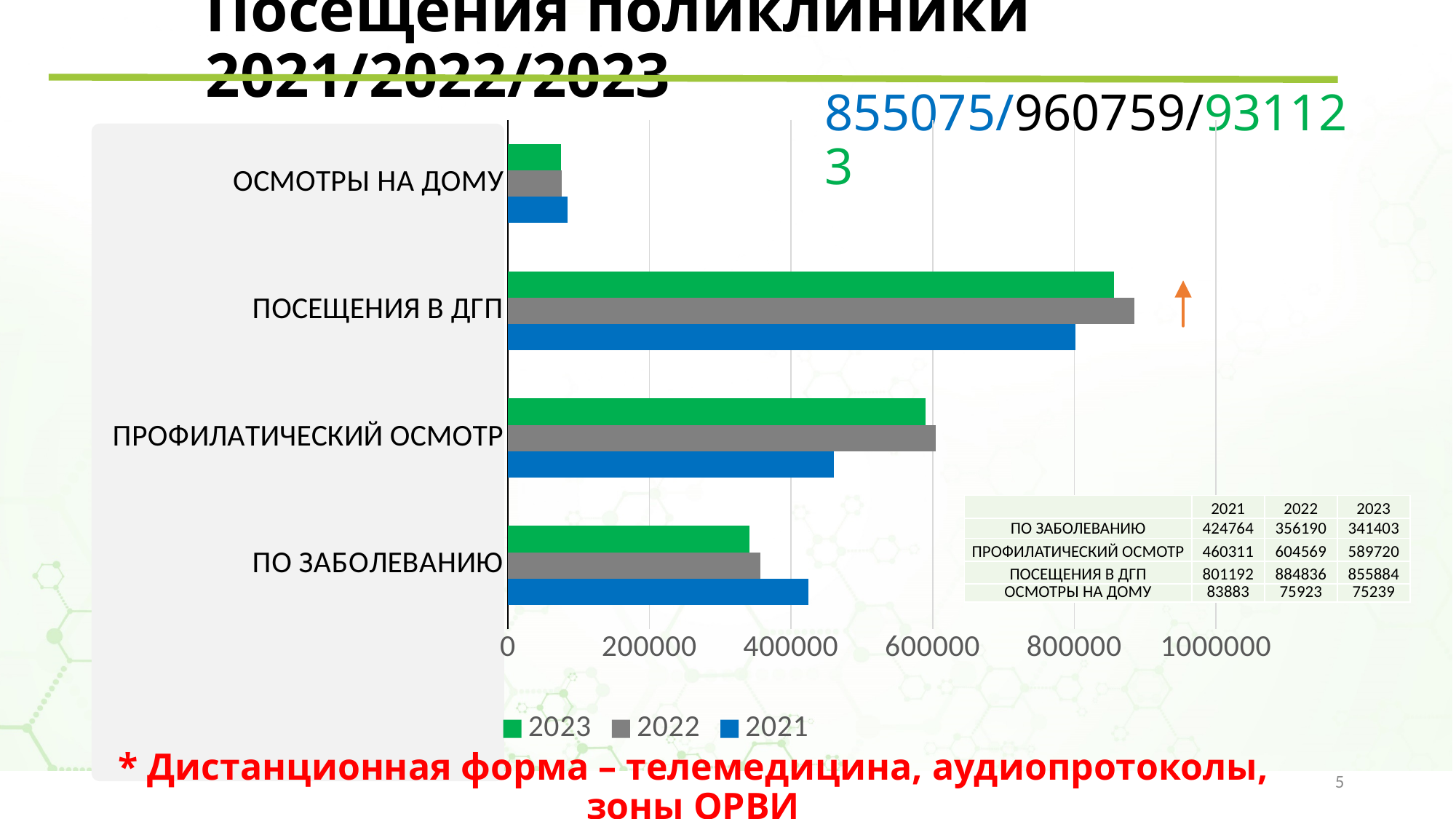
How many categories are shown on the chart's vertical axis? 4 What is the value for ОСМОТРЫ НА ДОМУ in 2023? 75239 What is the value for ПО ЗАБОЛЕВАНИЮ in 2021? 424764 Which colour represents the 2023 series in the chart? green Which is larger for ПО ЗАБОЛЕВАНИЮ: the 2021 value or the 2023 value? 2021 Which category has the lowest value in 2021? ОСМОТРЫ НА ДОМУ What type of chart is shown on the slide? bar chart How many series does the chart legend list? 3 What is the difference between the 2022 and 2021 values for ПРОФИЛАТИЧЕСКИЙ ОСМОТР? 144258 Which category has the highest value in 2023? ПОСЕЩЕНИЯ В ДГП Is the 2021 value for ПОСЕЩЕНИЯ В ДГП greater or less than 800000? greater What is the value for ПОСЕЩЕНИЯ В ДГП in 2022? 884836